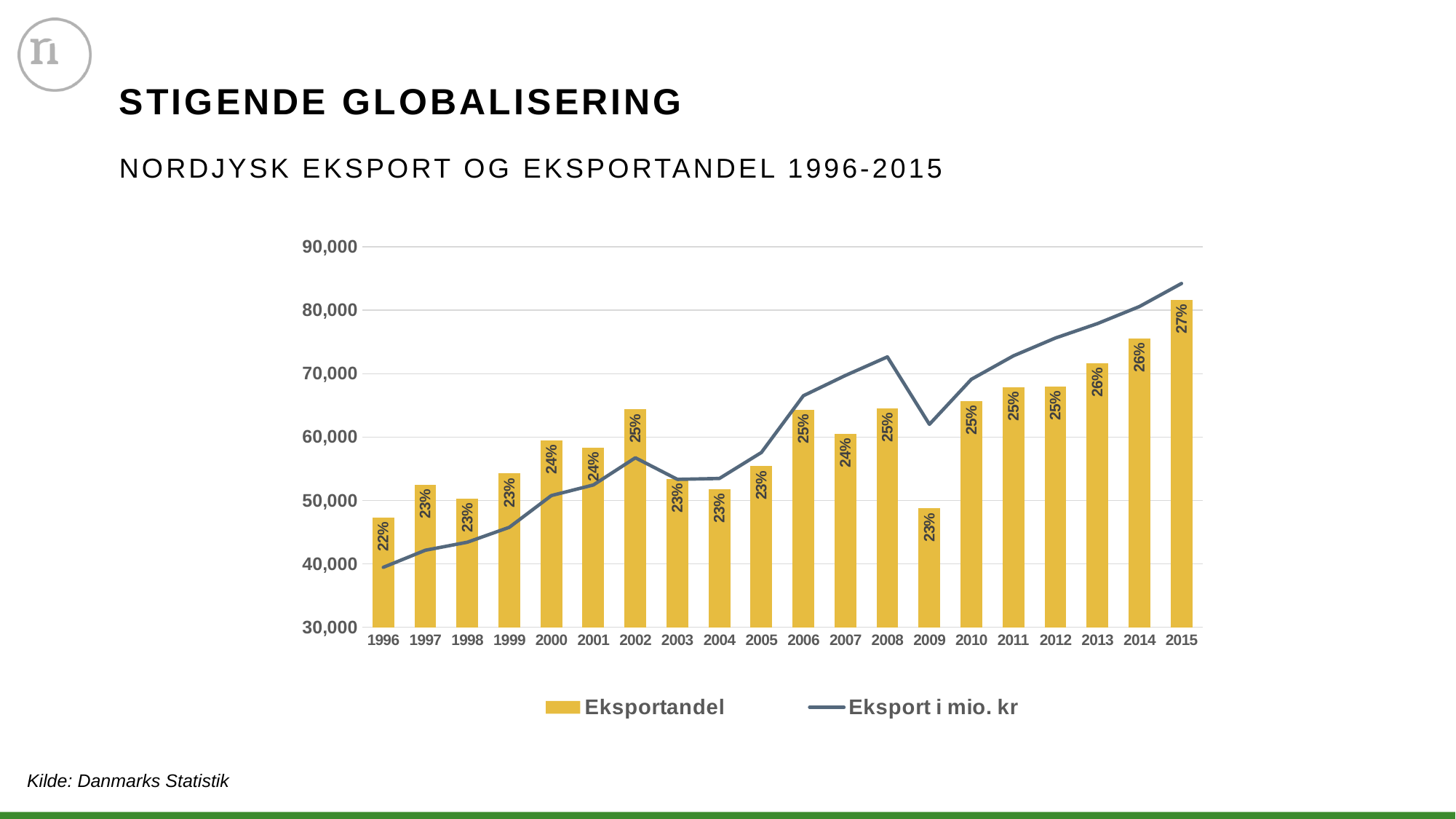
How many years are shown on the x axis? 20 What is the Eksportandel value for 2009? 23% What is the Eksportandel value for 1996? 22% Which year has the highest Eksportandel? 2015 What is the difference in Eksportandel between 2015 and 1996? 5 percentage points What kind of chart is shown on the slide? Combined bar and line chart Is the value of Eksport i mio. kr for 2009 greater or less than 60,000? greater Is the value of Eksport i mio. kr for 2015 greater or less than 80,000? greater How many series does the legend list? 2 Which year has the lowest Eksportandel? 1996 Which year has the larger Eksportandel, 2013 or 2007? 2013 What is the Eksportandel value for 2015? 27%